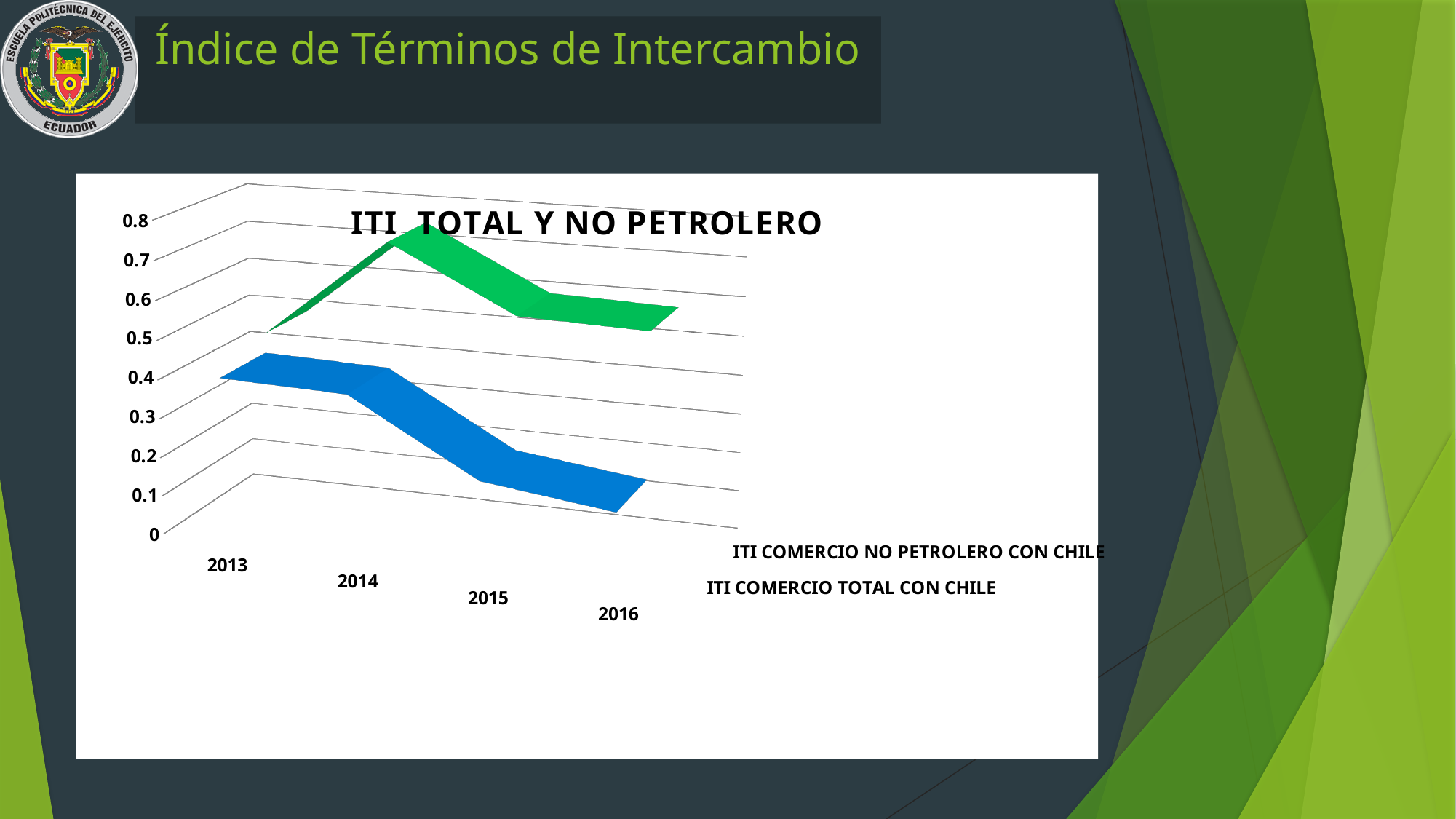
In which year does the ITI COMERCIO TOTAL CON CHILE series reach its lowest value? 2016 Is the value for ITI COMERCIO NO PETROLERO CON CHILE in 2014 greater or less than 0.5? greater In 2016, which series has the larger value, ITI COMERCIO NO PETROLERO CON CHILE or ITI COMERCIO TOTAL CON CHILE? ITI COMERCIO NO PETROLERO CON CHILE What type of chart is shown on the slide? Line chart How many years are shown on the x axis of the chart? 4 What is the title of the chart? ITI TOTAL Y NO PETROLERO In which year does the ITI COMERCIO NO PETROLERO CON CHILE series reach its highest value? 2014 Which colour represents the series ITI COMERCIO TOTAL CON CHILE? Blue Does the ITI COMERCIO TOTAL CON CHILE series rise or fall from 2013 to 2016? Fall Is the value for ITI COMERCIO TOTAL CON CHILE in 2016 greater or less than 0.3? less Does the ITI COMERCIO NO PETROLERO CON CHILE series rise or fall from 2014 to 2016? Fall